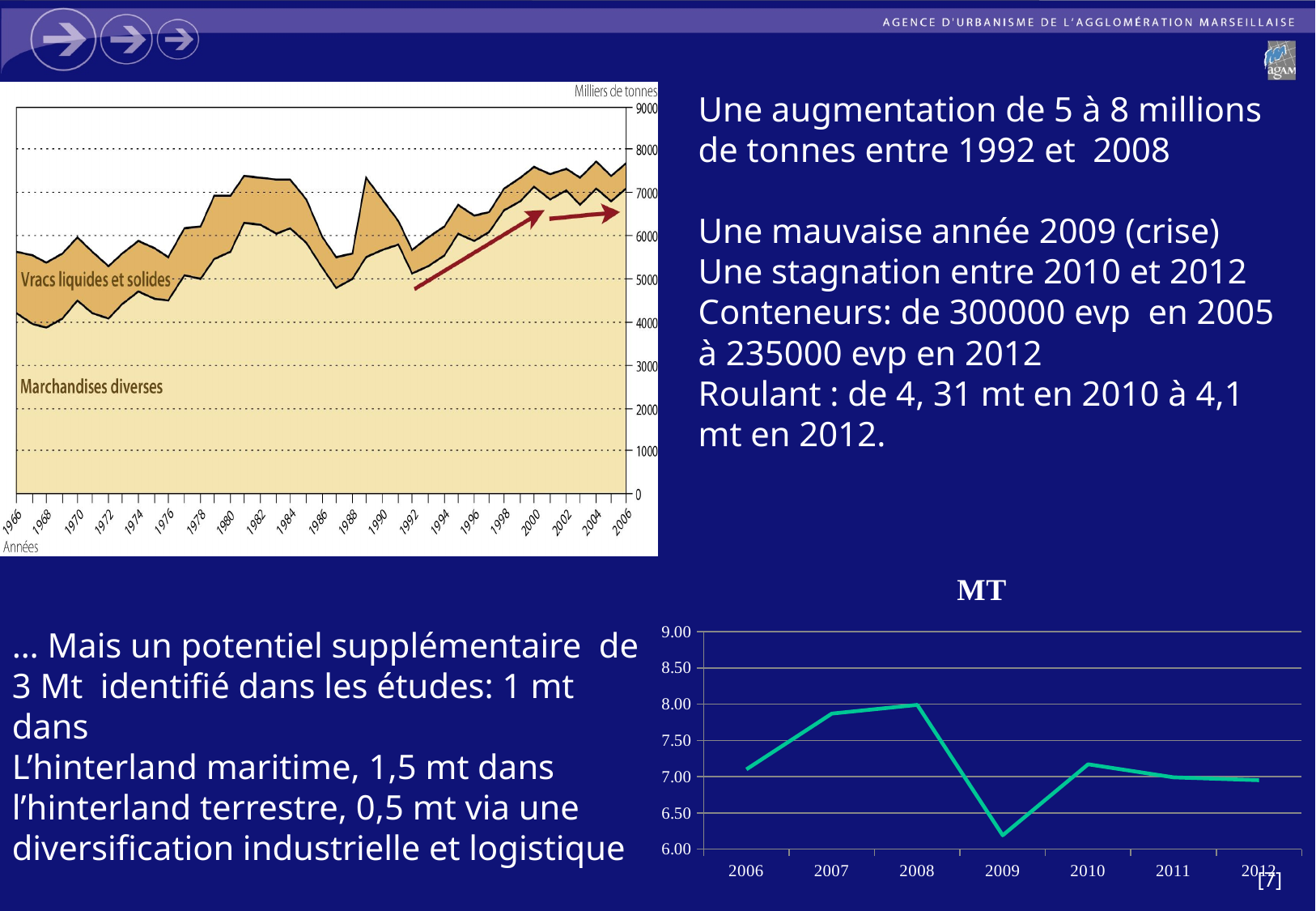
In the bottom-right "MT" chart, how many years are plotted on the x axis? 7 In the bottom-right "MT" chart, is the value for 2008 greater or less than 7.50? greater In the bottom-right "MT" chart, which year has the larger value, 2008 or 2009? 2008 What is the title of the bottom-right chart? MT In the top-left chart, what unit is shown on the y axis? Milliers de tonnes In the bottom-right "MT" chart, does the value rise or fall from 2008 to 2009? fall In the top-left chart, what are the two series shown? Vracs liquides et solides; Marchandises diverses In the bottom-right "MT" chart, which year has the lowest value? 2009 What kind of chart is the bottom-right chart titled "MT"? line chart In the top-left chart, is the total value in 2006 greater or less than 7000? greater In the bottom-right "MT" chart, which year has the highest value? 2008 In the bottom-right "MT" chart, is the value for 2009 greater or less than 6.50? less